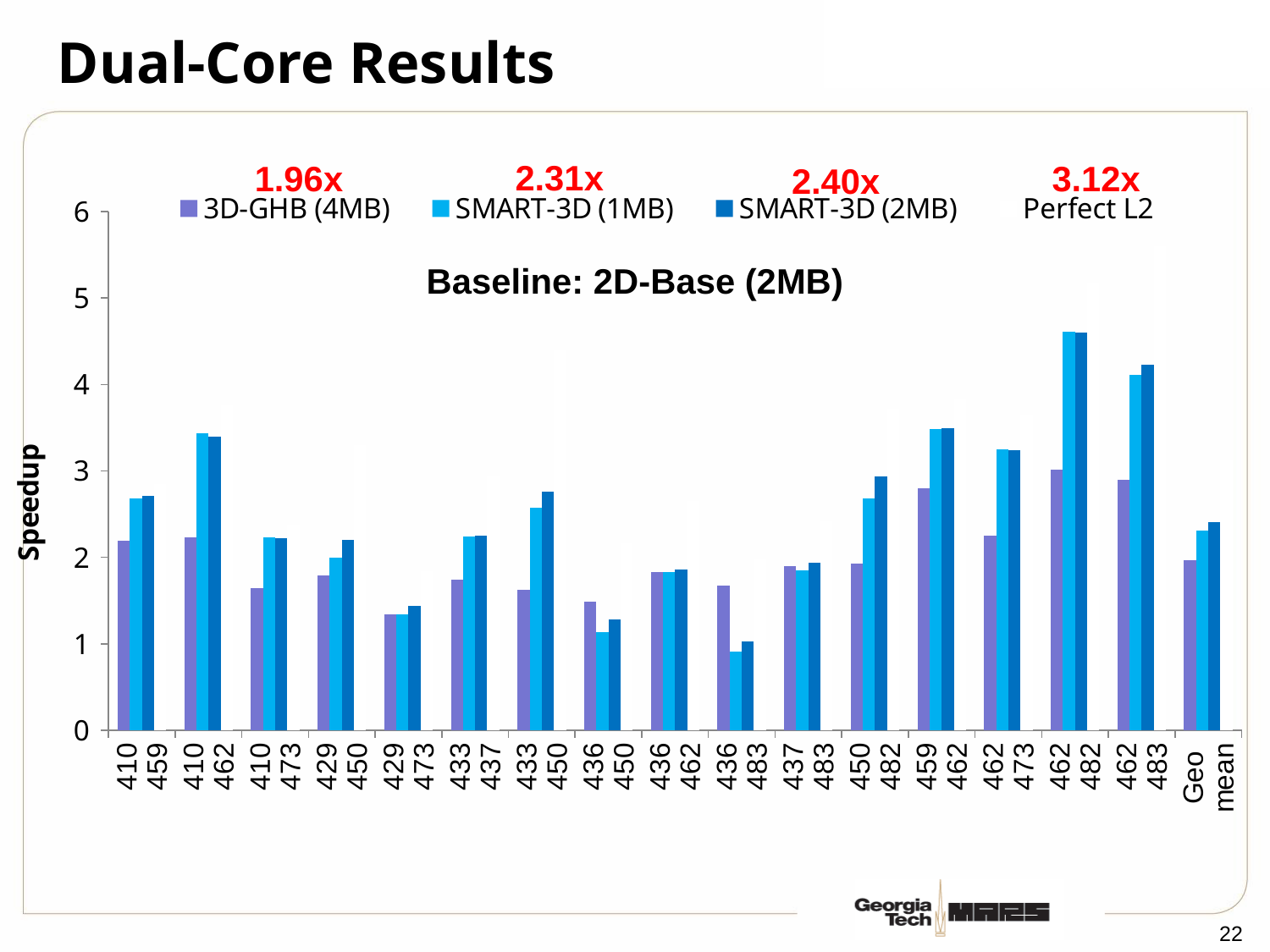
What baseline is stated on the chart? 2D-Base (2MB) Is the SMART-3D (1MB) speedup for 436 483 greater or less than 1? less Which category has the lowest 3D-GHB (4MB) speedup? 429 473 Is the SMART-3D (1MB) speedup for 462 482 greater or less than 4? greater How many categories are shown along the x axis of the chart? 17 What kind of chart is shown on the slide? bar chart For 462 483, which is larger: the 3D-GHB (4MB) speedup or the SMART-3D (2MB) speedup? SMART-3D (2MB) For 436 450, which is larger: the 3D-GHB (4MB) speedup or the SMART-3D (1MB) speedup? 3D-GHB (4MB) Which category has the highest SMART-3D (2MB) speedup? 462 482 What is the label of the y axis? Speedup Which category has the lowest SMART-3D (1MB) speedup? 436 483 Is the SMART-3D (2MB) speedup for Geo mean greater or less than 2? greater